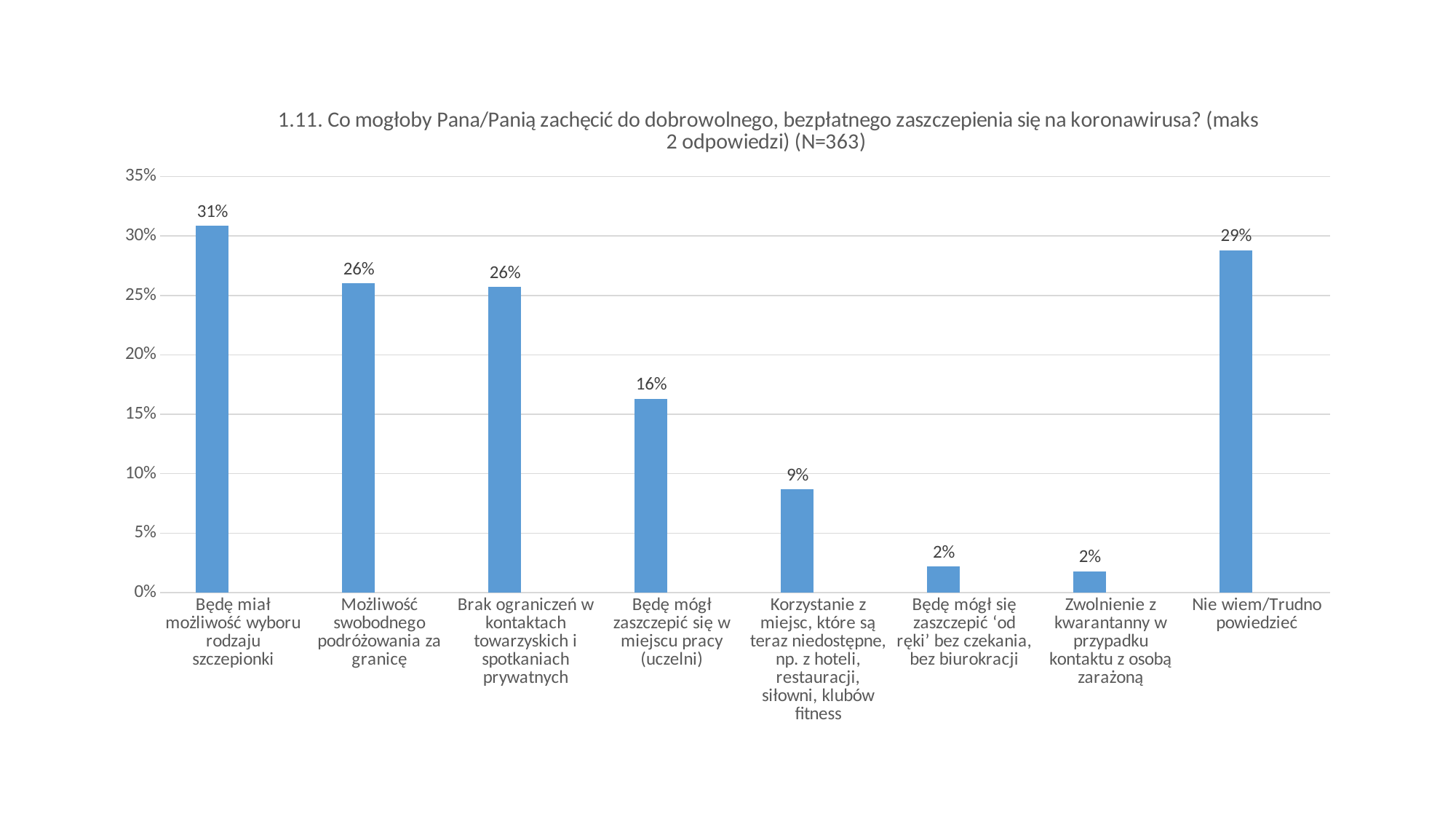
Which category has the highest value? Będę miał możliwość wyboru rodzaju szczepionki What is the value for "Będę miał możliwość wyboru rodzaju szczepionki"? 31% What is the difference between the values for "Będę miał możliwość wyboru rodzaju szczepionki" and "Nie wiem/Trudno powiedzieć"? 2% Is the value for "Korzystanie z miejsc, które są teraz niedostępne, np. z hoteli, restauracji, siłowni, klubów fitness" greater or less than 10%? less What is the value for "Nie wiem/Trudno powiedzieć"? 29% What is the N (sample size) stated in the chart title? 363 How many categories are plotted in the chart? 8 What is the value for "Zwolnienie z kwarantanny w przypadku kontaktu z osobą zarażoną"? 2% What is the value for "Będę mógł zaszczepić się w miejscu pracy (uczelni)"? 16% Which is larger: the value for "Korzystanie z miejsc, które są teraz niedostępne, np. z hoteli, restauracji, siłowni, klubów fitness" or the value for "Będę mógł się zaszczepić 'od ręki' bez czekania, bez biurokracji"? Korzystanie z miejsc, które są teraz niedostępne, np. z hoteli, restauracji, siłowni, klubów fitness What is the difference between the values for "Możliwość swobodnego podróżowania za granicę" and "Będę mógł zaszczepić się w miejscu pracy (uczelni)"? 10% What kind of chart is shown on the slide? bar chart